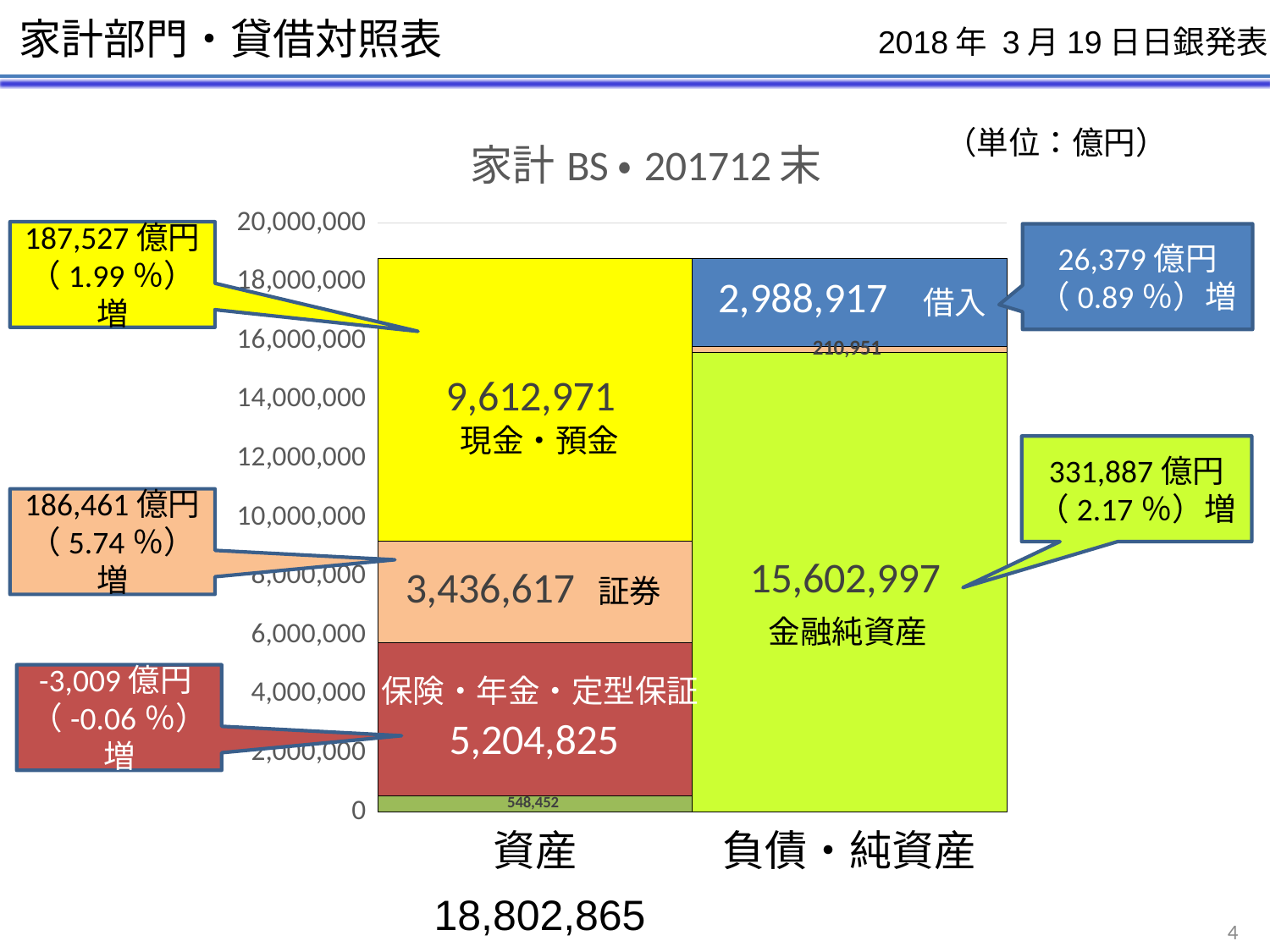
How many bars (categories) are shown on the x axis? 2 What is the value of 保険・年金・定型保証 in the 資産 bar? 5,204,825 Which segment of the 資産 bar is the largest? 現金・預金 What is the value of 金融純資産 in the 負債・純資産 bar? 15,602,997 Which is larger, 金融純資産 or 借入? 金融純資産 What is the value of 借入 in the 負債・純資産 bar? 2,988,917 What is the value of 証券 in the 資産 bar? 3,436,617 What is the total of the 資産 bar? 18,802,865 What is the value of 現金・預金 in the 資産 bar? 9,612,971 What kind of chart is shown on the slide? Stacked bar chart What is the difference between 現金・預金 and 証券 in the 資産 bar? 6,176,354